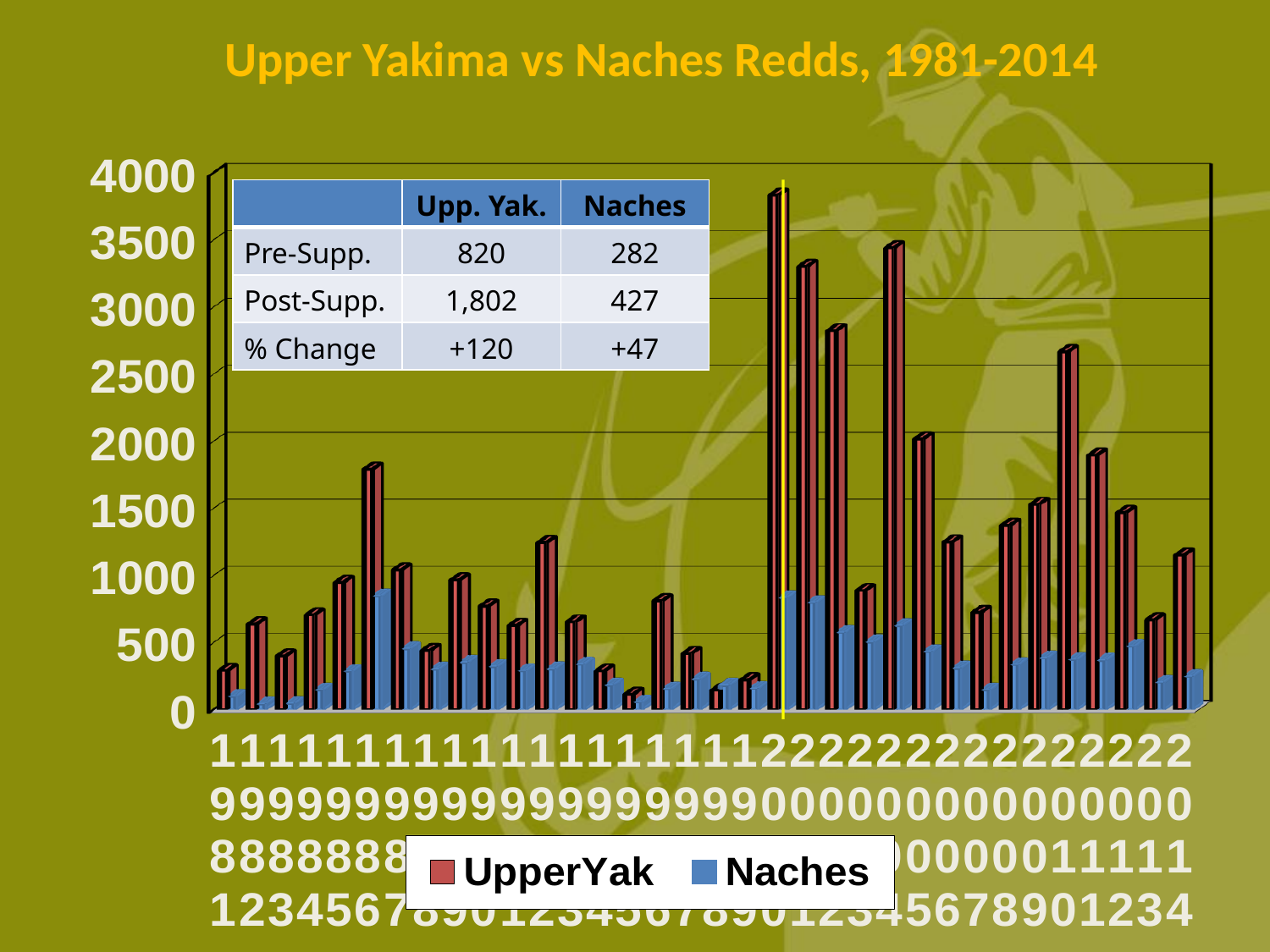
Is the UpperYak value for 1986 greater or less than 1500? greater How many years (categories) are plotted along the x axis? 34 What is the title of the chart? Upper Yakima vs Naches Redds, 1981-2014 Is the UpperYak value for 1995 greater or less than 500? less What are the two series named in the legend? UpperYak and Naches Is the highest UpperYak value greater or less than 3500? greater In which year does the UpperYak series reach its highest value? 2000 What kind of chart is shown on the slide? bar chart How many series does the legend list? 2